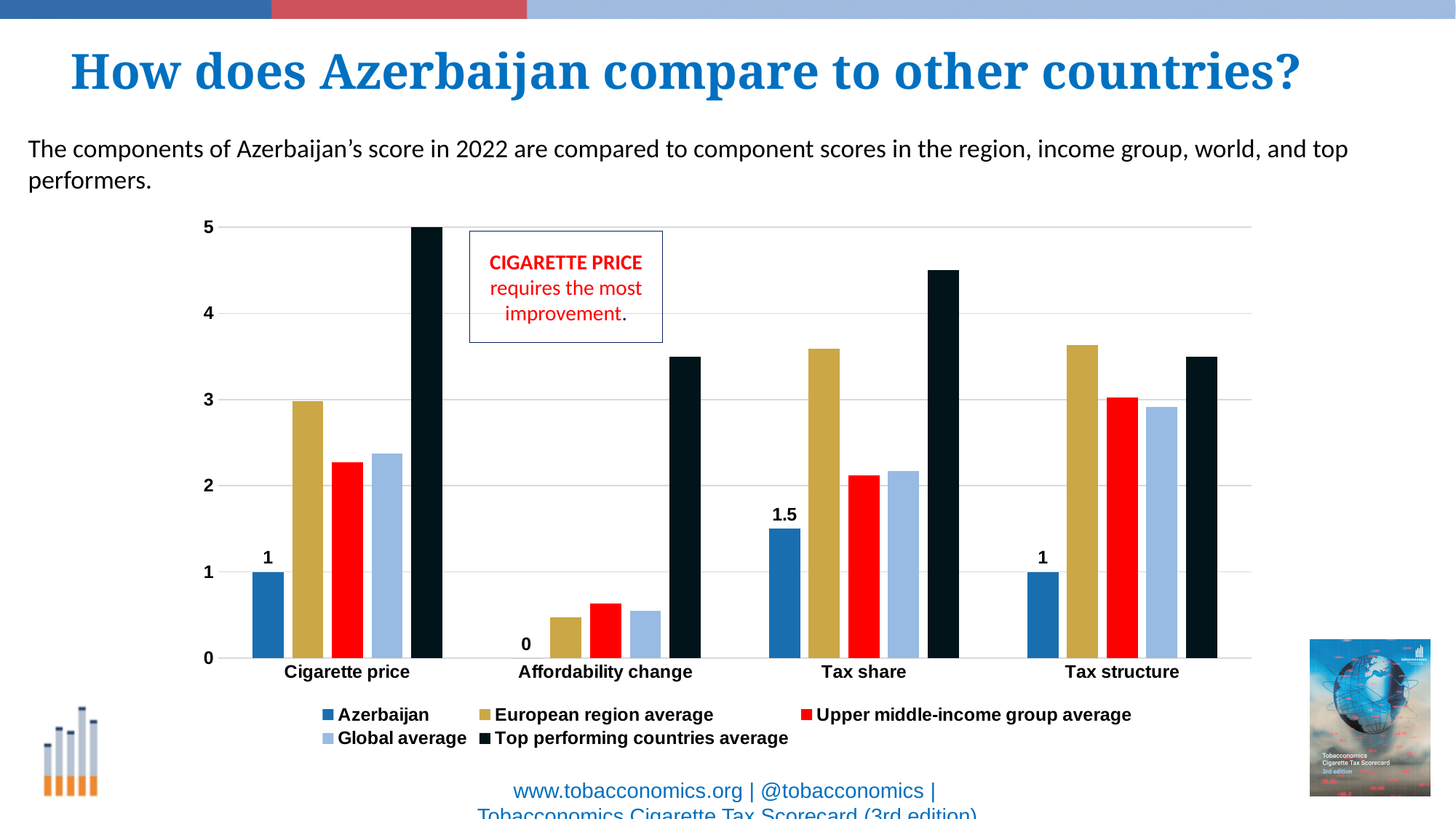
How many series does the legend list? 5 What is Azerbaijan's score for Affordability change? 0 Which component has Azerbaijan's lowest score? Affordability change Which component has Azerbaijan's highest score? Tax share What is Azerbaijan's score for Tax share? 1.5 What kind of chart is shown on the slide? Bar chart Is the Global average for Affordability change greater or less than 1? less For Cigarette price, which is larger: Azerbaijan or the European region average? European region average What is Azerbaijan's score for Cigarette price? 1 What is the Top performing countries average for Cigarette price? 5 What is the difference between Azerbaijan's Tax share score and its Cigarette price score? 0.5 Is the European region average for Tax share greater or less than 3? greater